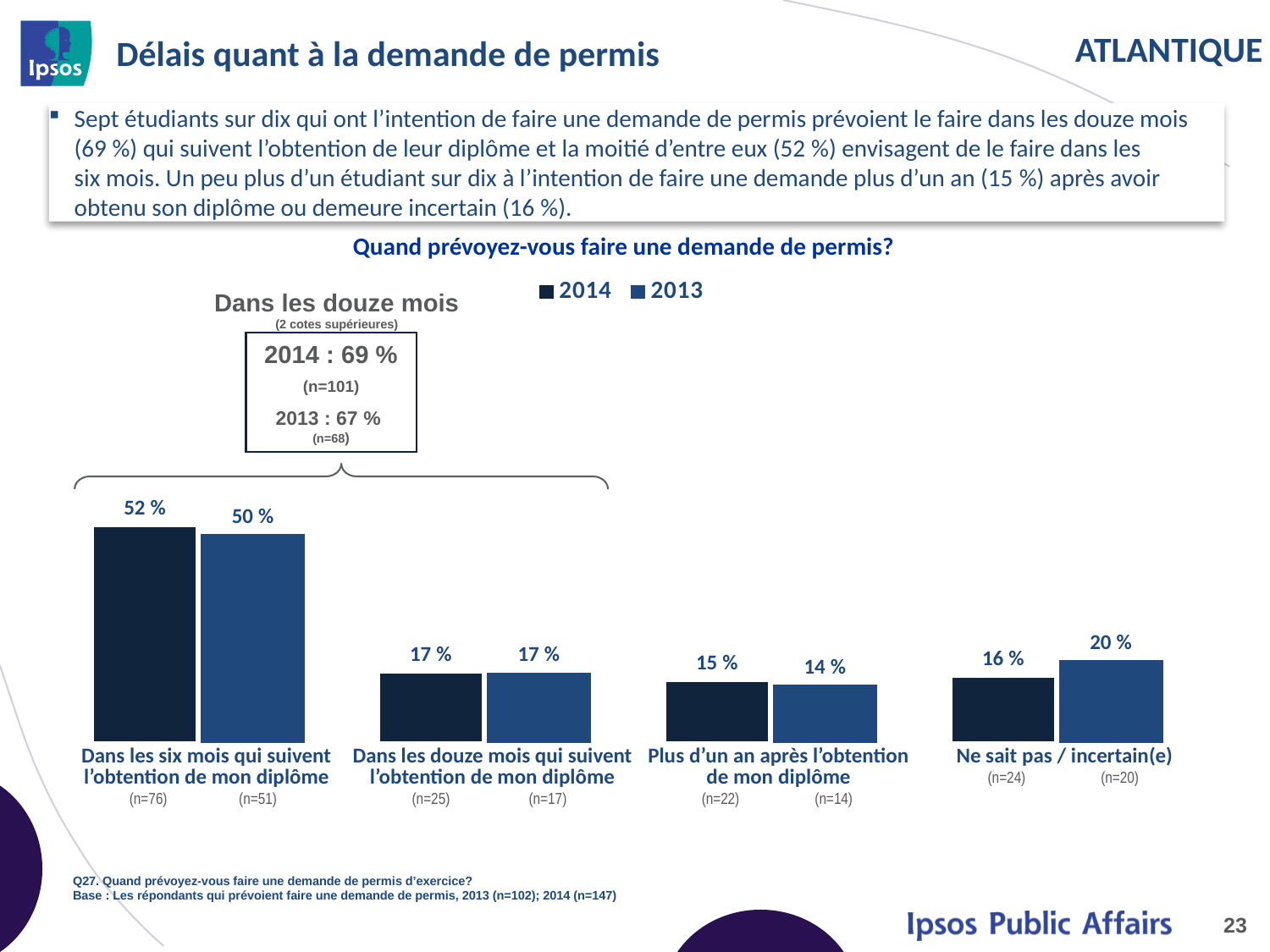
Which category has the lowest 2013 value? Plus d'un an après l'obtention de mon diplôme For "Ne sait pas / incertain(e)", which year has the larger value, 2014 or 2013? 2013 How many series does the chart legend list? 2 Which category has the highest 2014 value? Dans les six mois qui suivent l'obtention de mon diplôme How many categories are shown on the x axis of the chart? 4 What is the 2013 value for "Ne sait pas / incertain(e)"? 20 % What is the 2014 value for "Dans les six mois qui suivent l'obtention de mon diplôme"? 52 % What is the title of the chart? Quand prévoyez-vous faire une demande de permis? What is the 2013 value for "Plus d'un an après l'obtention de mon diplôme"? 14 % What type of chart is shown on the slide? Bar chart What is the difference between the 2014 and 2013 values for "Ne sait pas / incertain(e)"? 4 % What is the difference between the 2014 and 2013 values for "Dans les six mois qui suivent l'obtention de mon diplôme"? 2 %